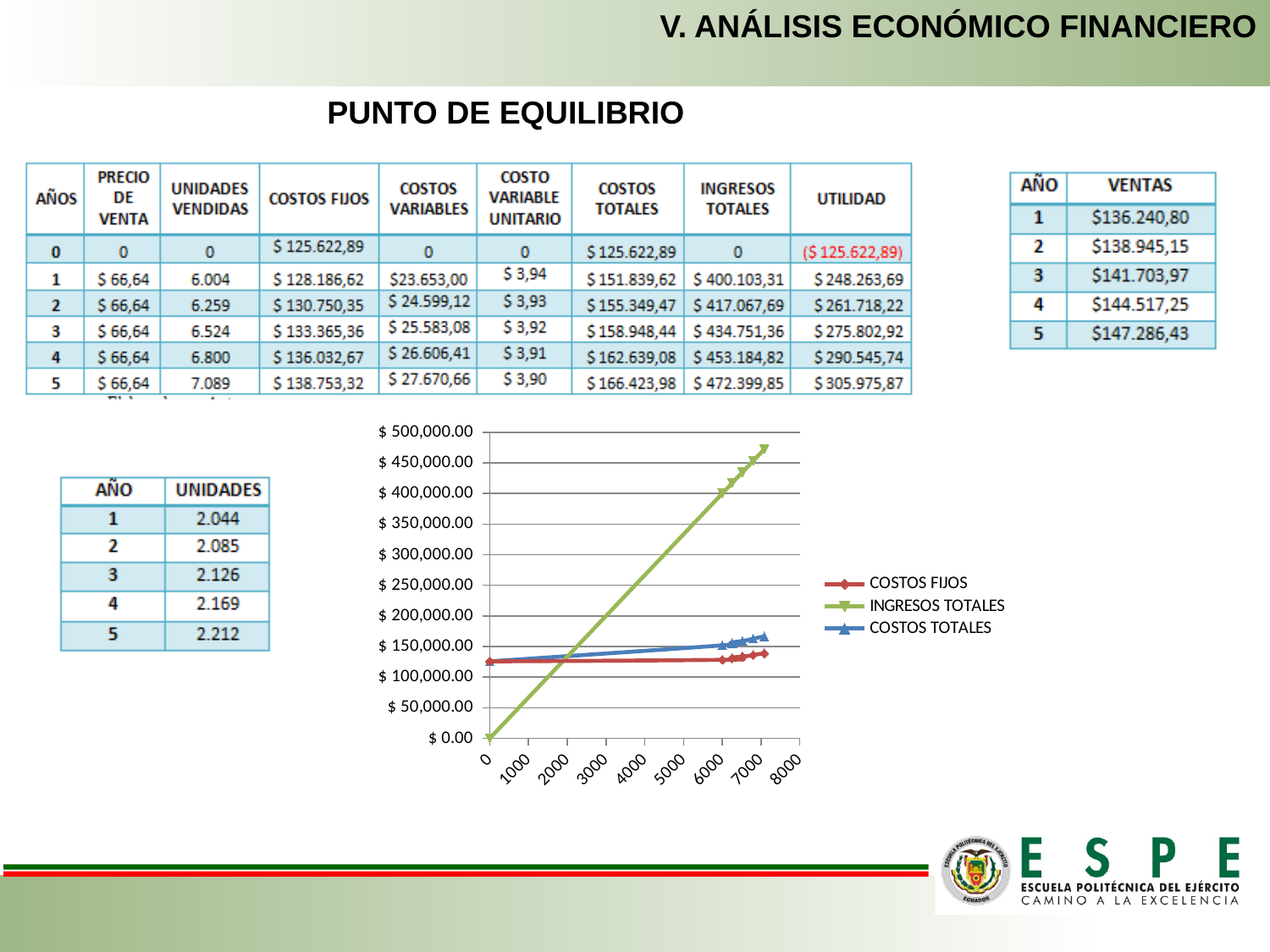
What kind of chart is shown on the slide? line chart What is the highest value shown on the chart's y axis? $ 500,000.00 Is the value of INGRESOS TOTALES at 2000 units greater or less than $200,000.00? less Does the INGRESOS TOTALES line rise or fall as the number of units increases along the x axis? rise What are the three series named in the chart's legend? COSTOS FIJOS, INGRESOS TOTALES, COSTOS TOTALES At 0 units, which series is higher: COSTOS FIJOS or INGRESOS TOTALES? COSTOS FIJOS Is the value of INGRESOS TOTALES at 7000 units greater or less than $400,000.00? greater How many series does the chart's legend list? 3 Is the value of COSTOS TOTALES at 7000 units greater or less than $200,000.00? less Which series reaches the highest value on the chart? INGRESOS TOTALES At 7000 units, which series is higher: INGRESOS TOTALES or COSTOS TOTALES? INGRESOS TOTALES